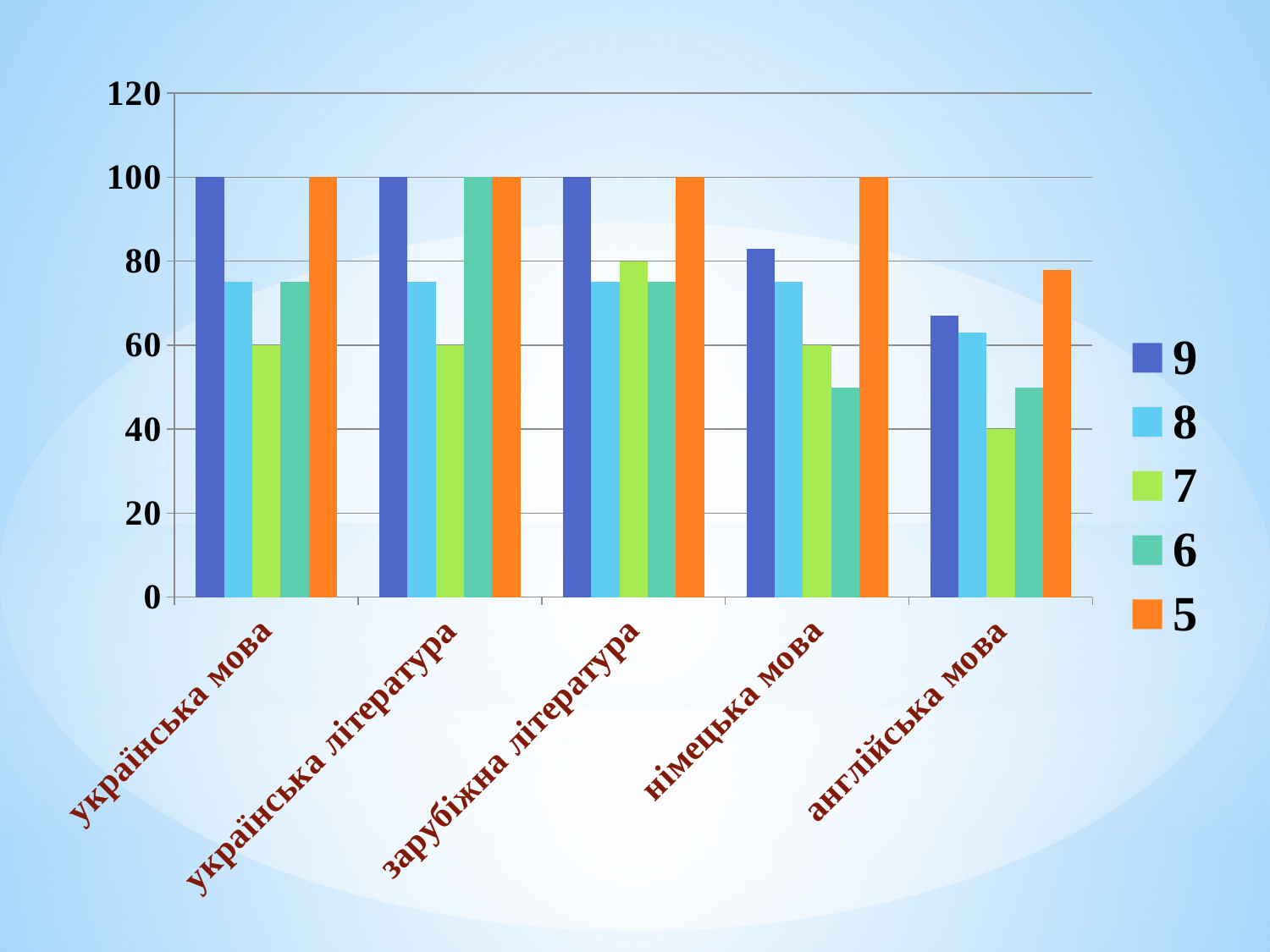
Is the value for series 5 in англійська мова greater or less than 60? greater What is the value for series 9 in the category українська мова? 100 What is the value for series 7 in the category англійська мова? 40 What is the value for series 5 in the category німецька мова? 100 What kind of chart is shown on the slide? bar chart How many series does the legend list? 5 What is the value for series 7 in the category українська мова? 60 Is the value for series 9 in англійська мова greater or less than 80? less In the category німецька мова, which is larger: series 9 or series 7? 9 For series 7, which category has the lowest value? англійська мова Is the value for series 8 in українська мова greater or less than 80? less How many categories are shown on the x axis? 5